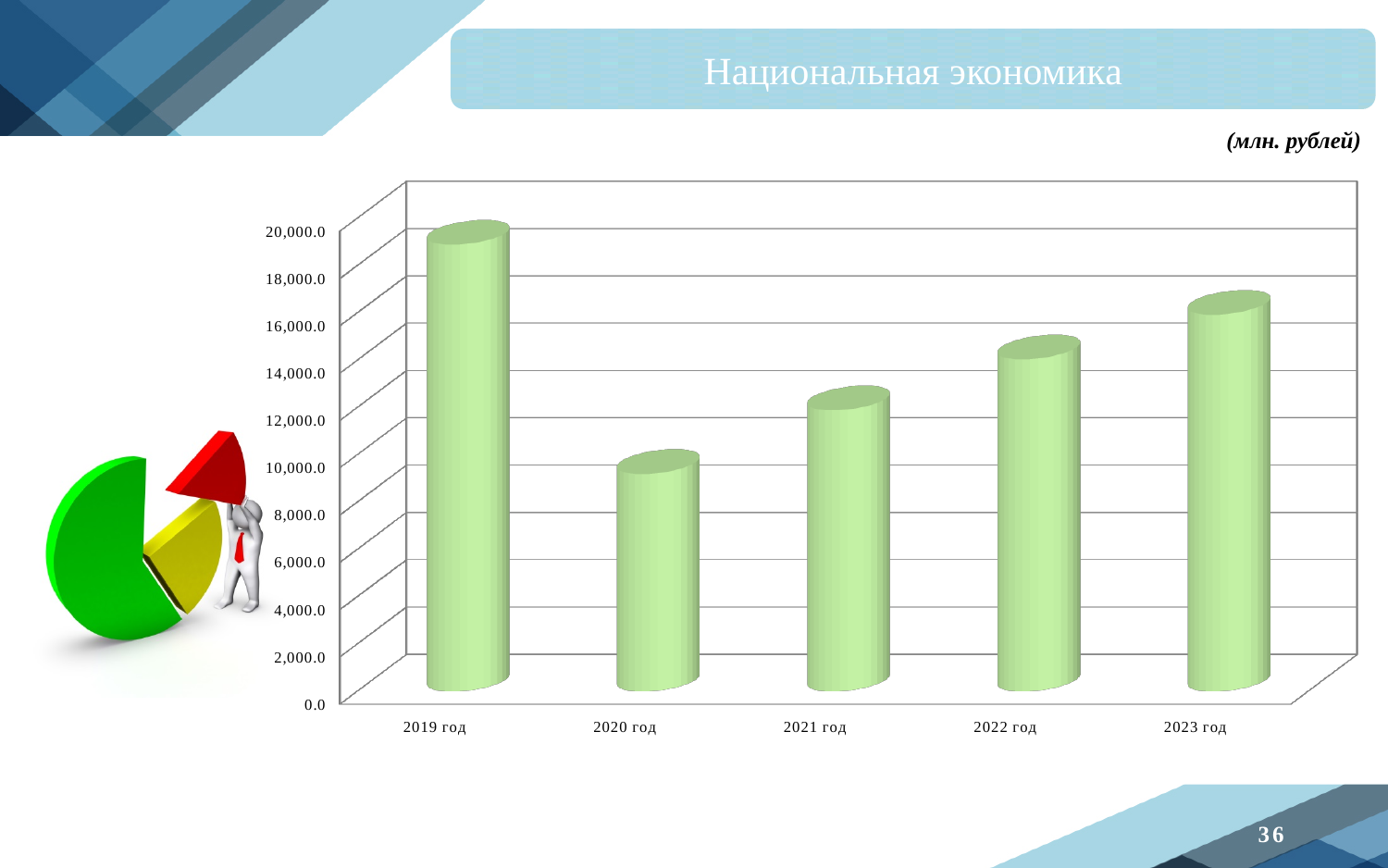
Is the value for 2023 год greater or less than 18,000.0? less Is the value for 2019 год greater or less than 18,000.0? greater Is the value for 2020 год greater or less than 12,000.0? less What unit of measurement is indicated for the chart on the slide? млн. рублей From 2020 год to 2023 год, do the values rise or fall? rise Which year has the highest value in the chart? 2019 год Which is larger, the value for 2019 год or the value for 2023 год? 2019 год Which is larger, the value for 2021 год or the value for 2022 год? 2022 год How many years are shown on the x axis of the chart? 5 What kind of chart is shown on the slide? bar chart Which year has the lowest value in the chart? 2020 год